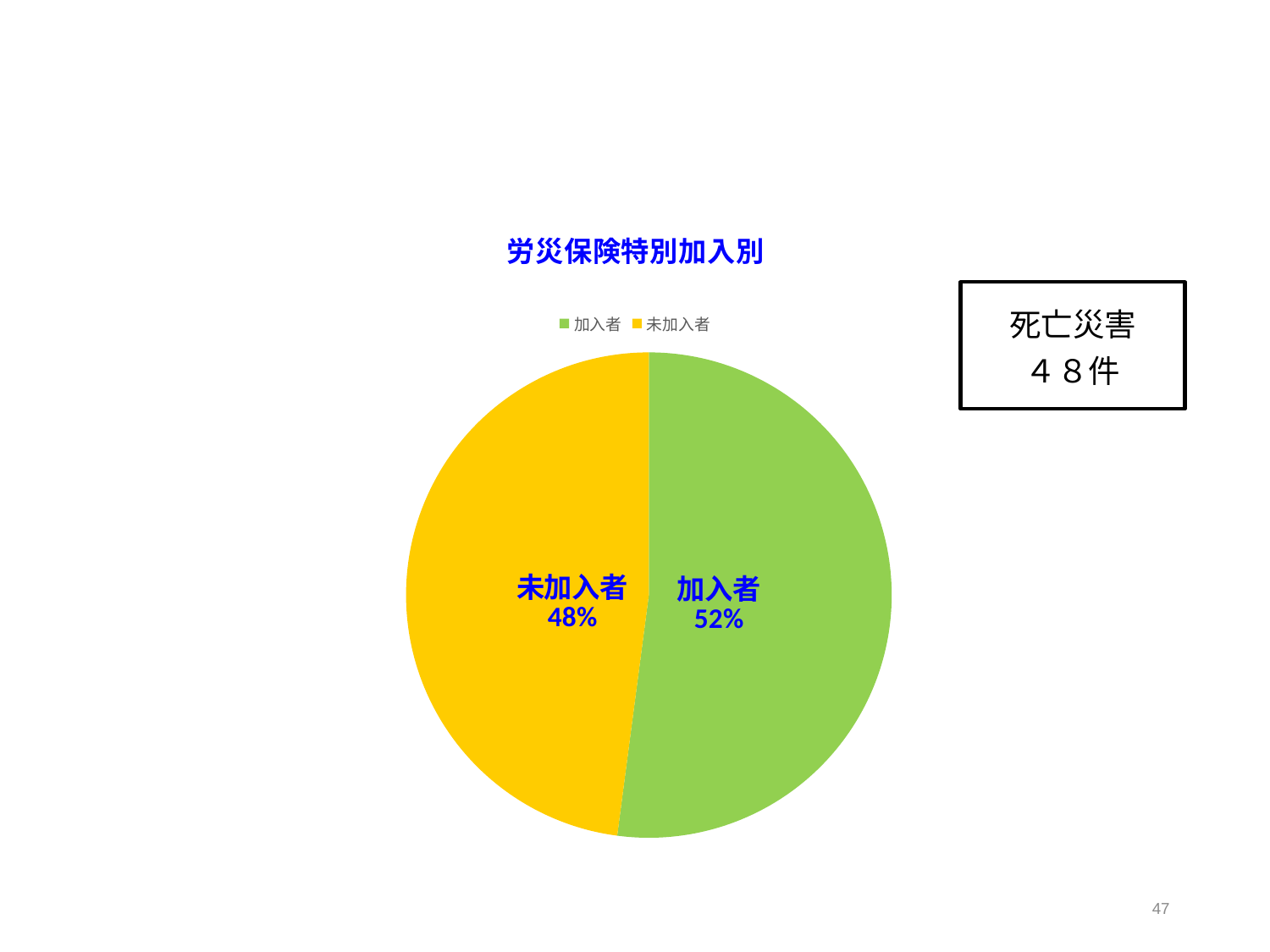
What colour is the 未加入者 slice? yellow What type of chart is shown on the slide? pie chart Is the share for 加入者 greater or less than 50%? greater What is the difference in percentage points between 加入者 and 未加入者? 4 How many entries does the legend list? 2 What share of the pie does 加入者 represent? 52% Which slice is the smallest in the pie chart? 未加入者 How many slices does the pie chart have? 2 What is the title of the chart? 労災保険特別加入別 What share of the pie does 未加入者 represent? 48% Which slice is the largest in the pie chart? 加入者 Which is larger, the share for 加入者 or the share for 未加入者? 加入者